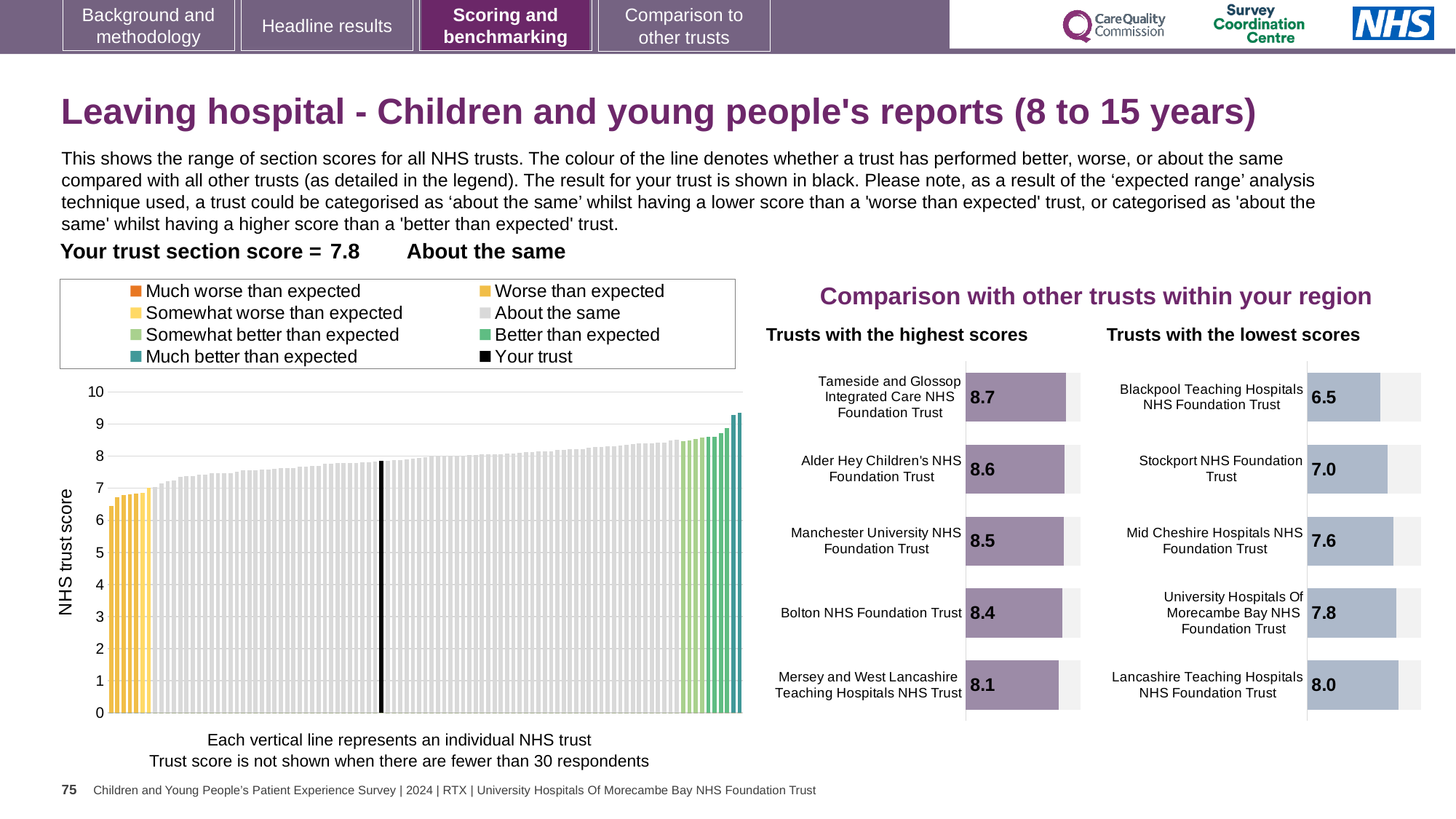
How many entries does the legend above the large chart on the left list? 8 What kind of chart is the large chart on the left showing NHS trust scores? Bar chart In the 'Trusts with the highest scores' chart, what is the difference between the scores of Tameside and Glossop Integrated Care NHS Foundation Trust and Mersey and West Lancashire Teaching Hospitals NHS Trust? 0.6 In the 'Trusts with the highest scores' chart, what is the score for Tameside and Glossop Integrated Care NHS Foundation Trust? 8.7 In the 'Trusts with the lowest scores' chart, which has the larger score: Stockport NHS Foundation Trust or Mid Cheshire Hospitals NHS Foundation Trust? Mid Cheshire Hospitals NHS Foundation Trust In the 'Trusts with the lowest scores' chart, which trust has the highest score shown? Lancashire Teaching Hospitals NHS Foundation Trust In the large chart on the left, do the trust scores rise or fall from left to right? Rise In the 'Trusts with the highest scores' chart, which trust has the lowest score shown? Mersey and West Lancashire Teaching Hospitals NHS Trust In the 'Trusts with the lowest scores' chart, what is the difference between the scores of Lancashire Teaching Hospitals NHS Foundation Trust and Blackpool Teaching Hospitals NHS Foundation Trust? 1.5 In the 'Trusts with the lowest scores' chart, what is the score for Blackpool Teaching Hospitals NHS Foundation Trust? 6.5 In the 'Trusts with the highest scores' chart, how many trusts are listed? 5 In the 'Trusts with the lowest scores' chart, what is the score for University Hospitals Of Morecambe Bay NHS Foundation Trust? 7.8